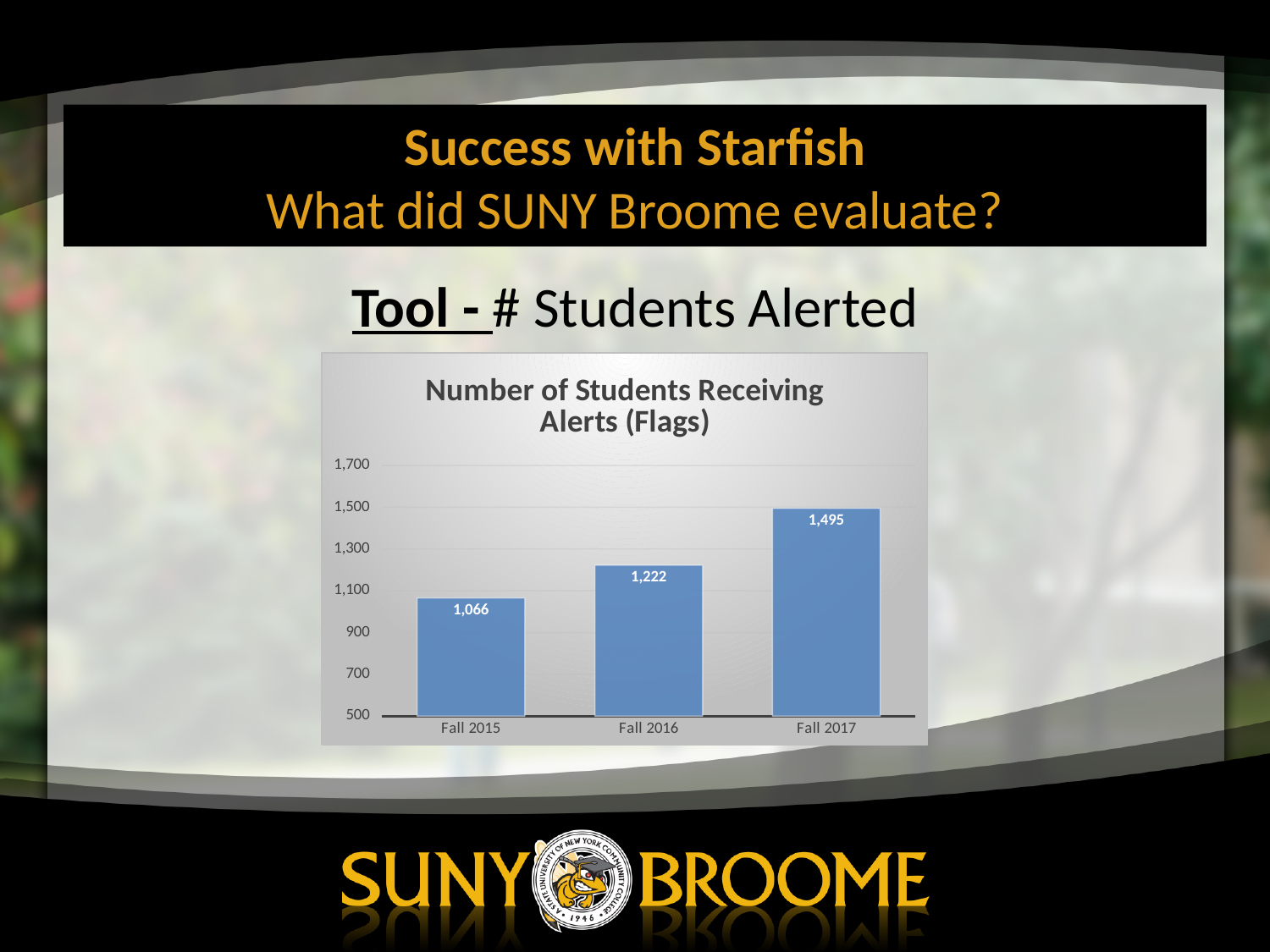
What is the number of students receiving alerts in Fall 2016? 1,222 What is the difference between the number of students receiving alerts in Fall 2016 and Fall 2015? 156 Which semester has the lowest number of students receiving alerts? Fall 2015 Which semester has the highest number of students receiving alerts? Fall 2017 Do the values rise or fall from Fall 2015 to Fall 2017? rise Which is larger, the number of students receiving alerts in Fall 2016 or in Fall 2017? Fall 2017 What is the number of students receiving alerts in Fall 2017? 1,495 What kind of chart is shown on the slide? bar chart What is the difference between the number of students receiving alerts in Fall 2017 and Fall 2015? 429 What is the number of students receiving alerts in Fall 2015? 1,066 How many semesters are shown on the chart? 3 Is the value for Fall 2016 greater or less than 1,300? less